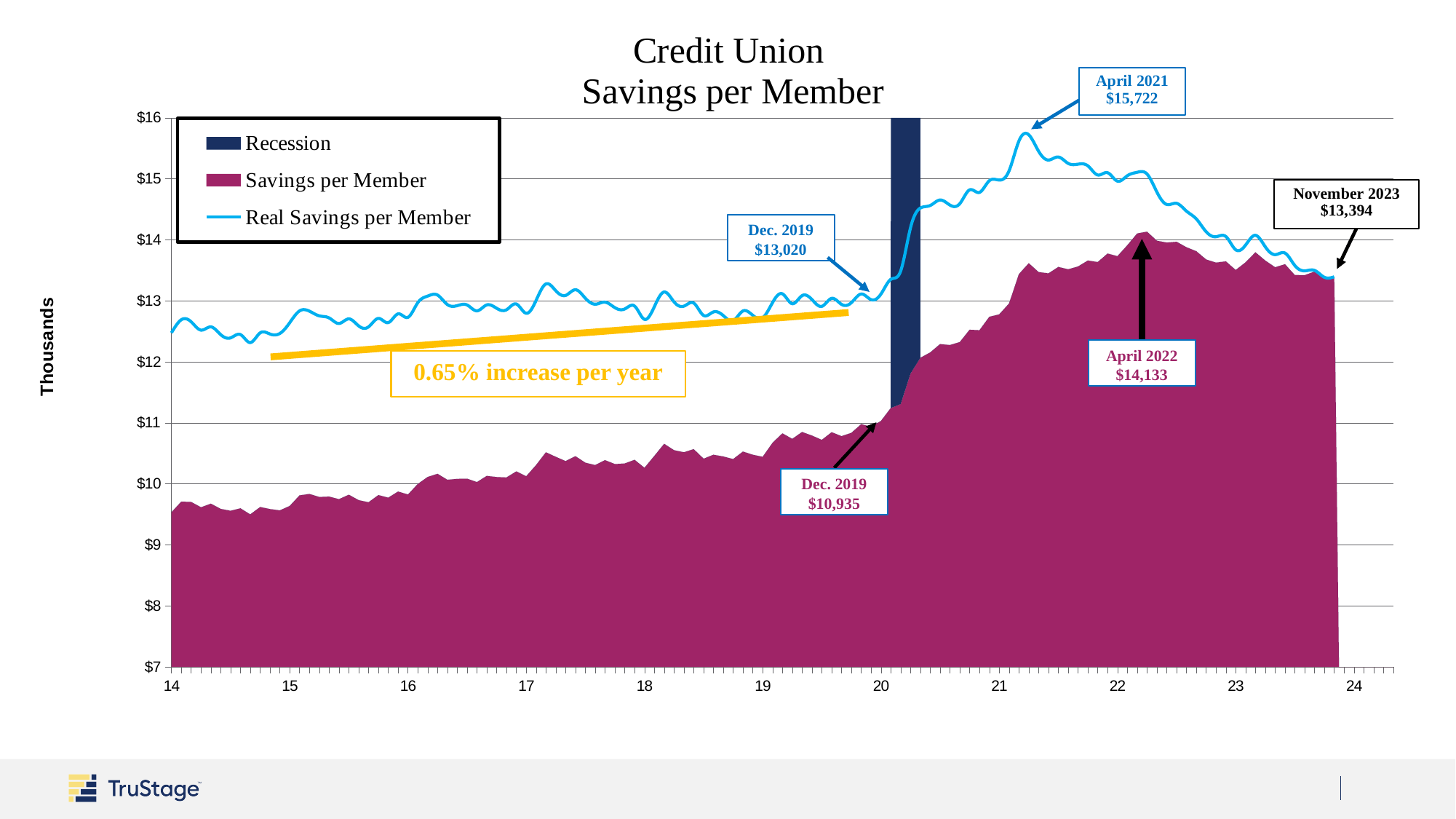
In Dec. 2019, how much higher is Real Savings per Member than Savings per Member? $2,085 What is the labeled value of Savings per Member in April 2022? $14,133 How much did Savings per Member increase from Dec. 2019 to April 2022? $3,198 How many entries does the legend list? 3 What is the labeled value of Real Savings per Member in April 2021? $15,722 What value is labeled for November 2023? $13,394 How much did Real Savings per Member increase from Dec. 2019 ($13,020) to April 2021 ($15,722)? $2,702 Is the value of Savings per Member at the start of 2014 greater or less than $10? less What is the labeled value of Savings per Member in Dec. 2019? $10,935 What is the labeled value of Real Savings per Member in Dec. 2019? $13,020 What annual rate of increase is annotated on the chart? 0.65% increase per year In Dec. 2019, which is larger: Real Savings per Member or Savings per Member? Real Savings per Member